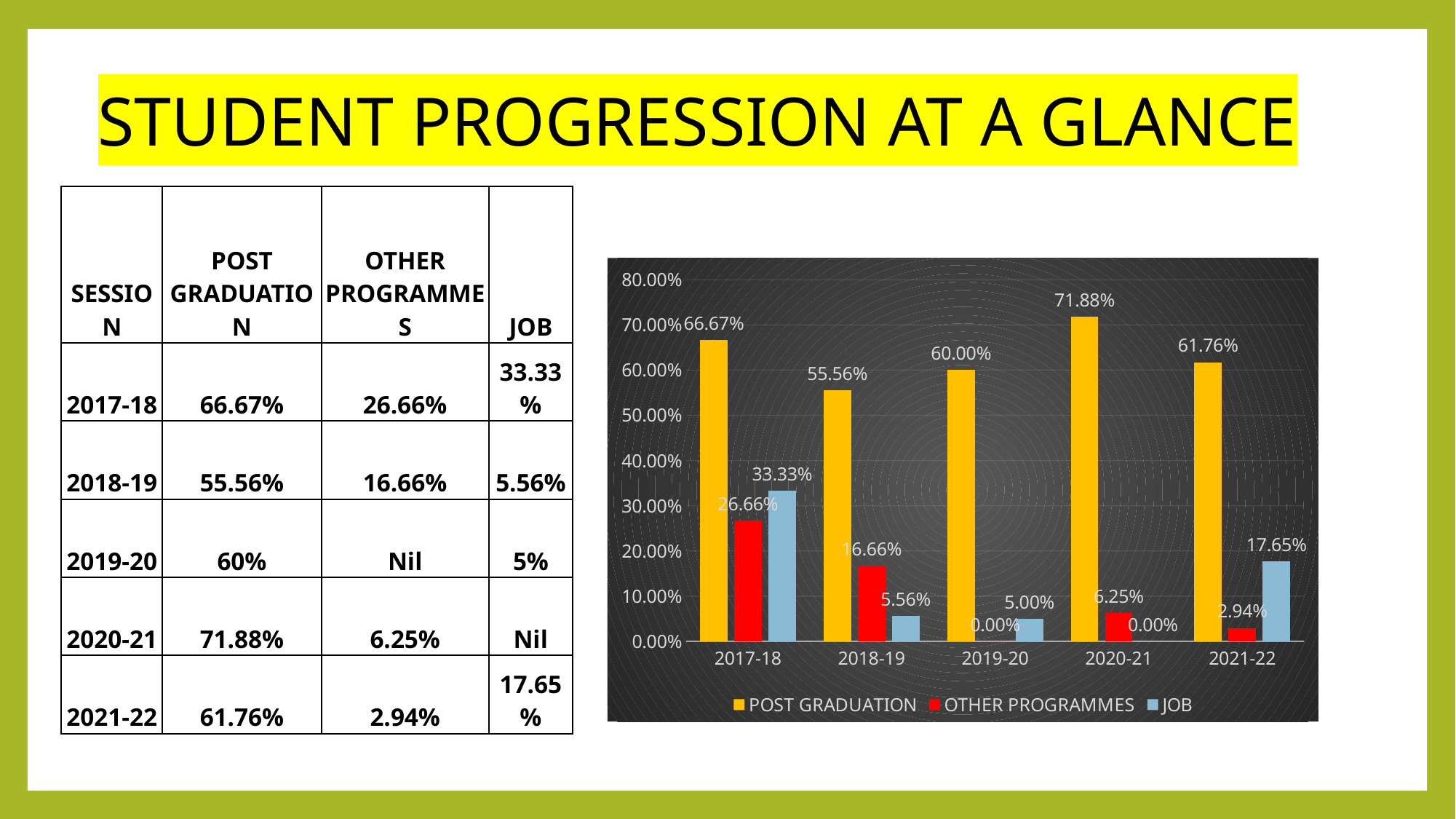
How many sessions are shown on the x axis of the chart? 5 Which colour represents the JOB series in the chart? light blue What is the OTHER PROGRAMMES value for 2018-19 in the chart? 16.66% What is the JOB value for 2017-18 in the chart? 33.33% What is the difference between the POST GRADUATION values for 2020-21 and 2018-19? 16.32% Which session has the highest POST GRADUATION value in the chart? 2020-21 Which is larger in the chart: the JOB value for 2021-22 or the JOB value for 2018-19? 2021-22 Which session has the lowest POST GRADUATION value in the chart? 2018-19 What is the POST GRADUATION value for 2020-21 in the chart? 71.88% Is the POST GRADUATION value for 2019-20 greater or less than 50.00%? greater What kind of chart is shown on the slide? bar chart How many series does the chart legend list? 3